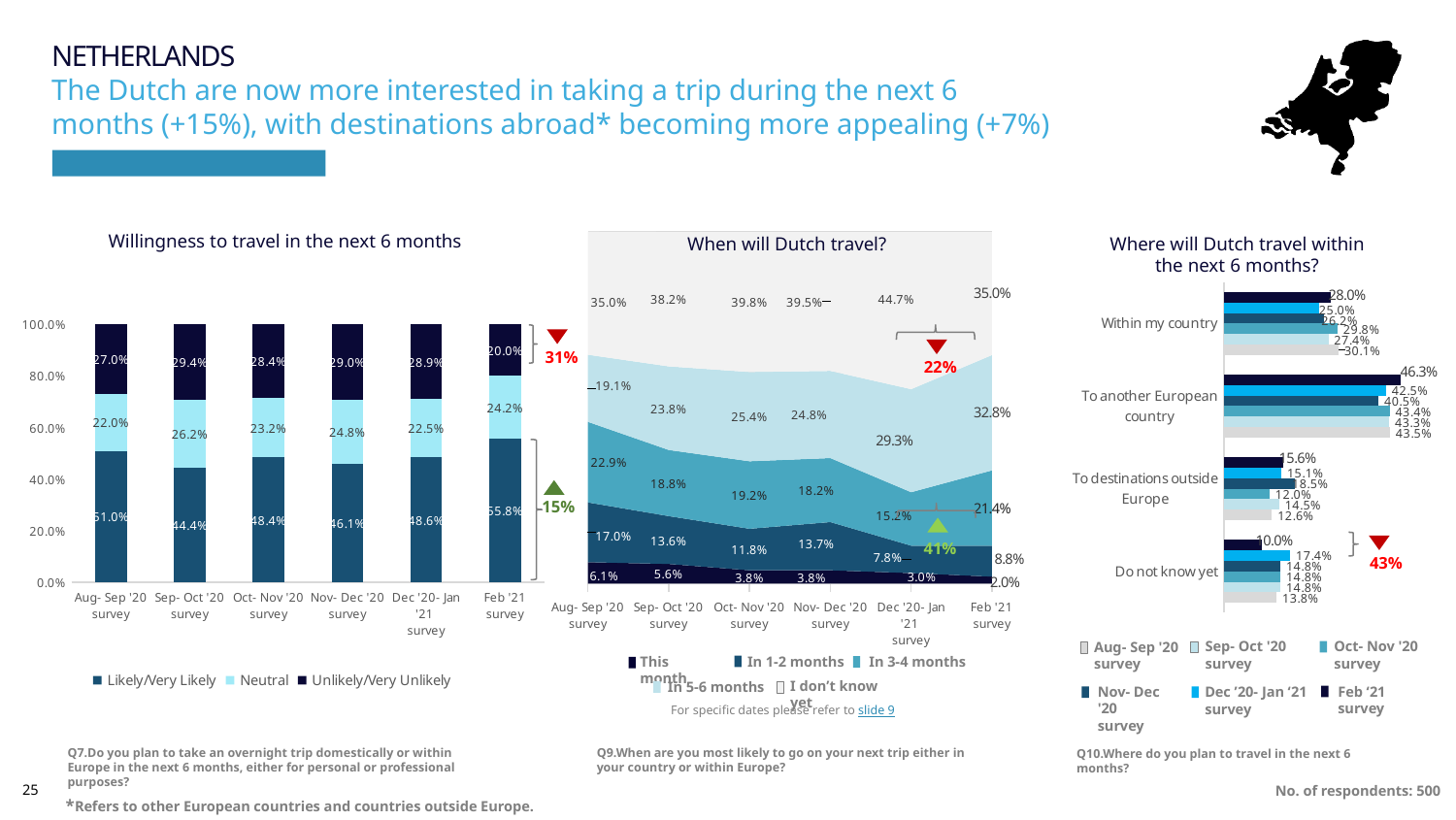
In the 'When will Dutch travel?' chart, what is the 'In 5-6 months' value for the Feb '21 survey? 32.8% In the 'When will Dutch travel?' chart, which is larger for the Feb '21 survey: 'In 3-4 months' or 'In 1-2 months'? In 3-4 months What kind of chart is 'Willingness to travel in the next 6 months'? Stacked bar chart In the 'Willingness to travel in the next 6 months' chart, which survey has the lowest Likely/Very Likely value? Sep-Oct '20 survey In the 'Willingness to travel in the next 6 months' chart, what is the Unlikely/Very Unlikely value for the Aug-Sep '20 survey? 27.0% In the 'When will Dutch travel?' chart, does the 'This month' value rise or fall from the Aug-Sep '20 survey to the Feb '21 survey? Fall In the 'Willingness to travel in the next 6 months' chart, what is the Likely/Very Likely value for the Feb '21 survey? 55.8% How many destination categories are shown in the 'Where will Dutch travel within the next 6 months?' chart? 4 In the 'When will Dutch travel?' chart, what is the 'I don't know yet' value for the Dec '20-Jan '21 survey? 44.7% In the 'Willingness to travel in the next 6 months' chart, which survey has the highest Likely/Very Likely value? Feb '21 survey In the 'Willingness to travel in the next 6 months' chart, how much higher is the Neutral value in the Sep-Oct '20 survey than in the Aug-Sep '20 survey? 4.2 percentage points How many series does the legend of the 'Willingness to travel in the next 6 months' chart list? 3